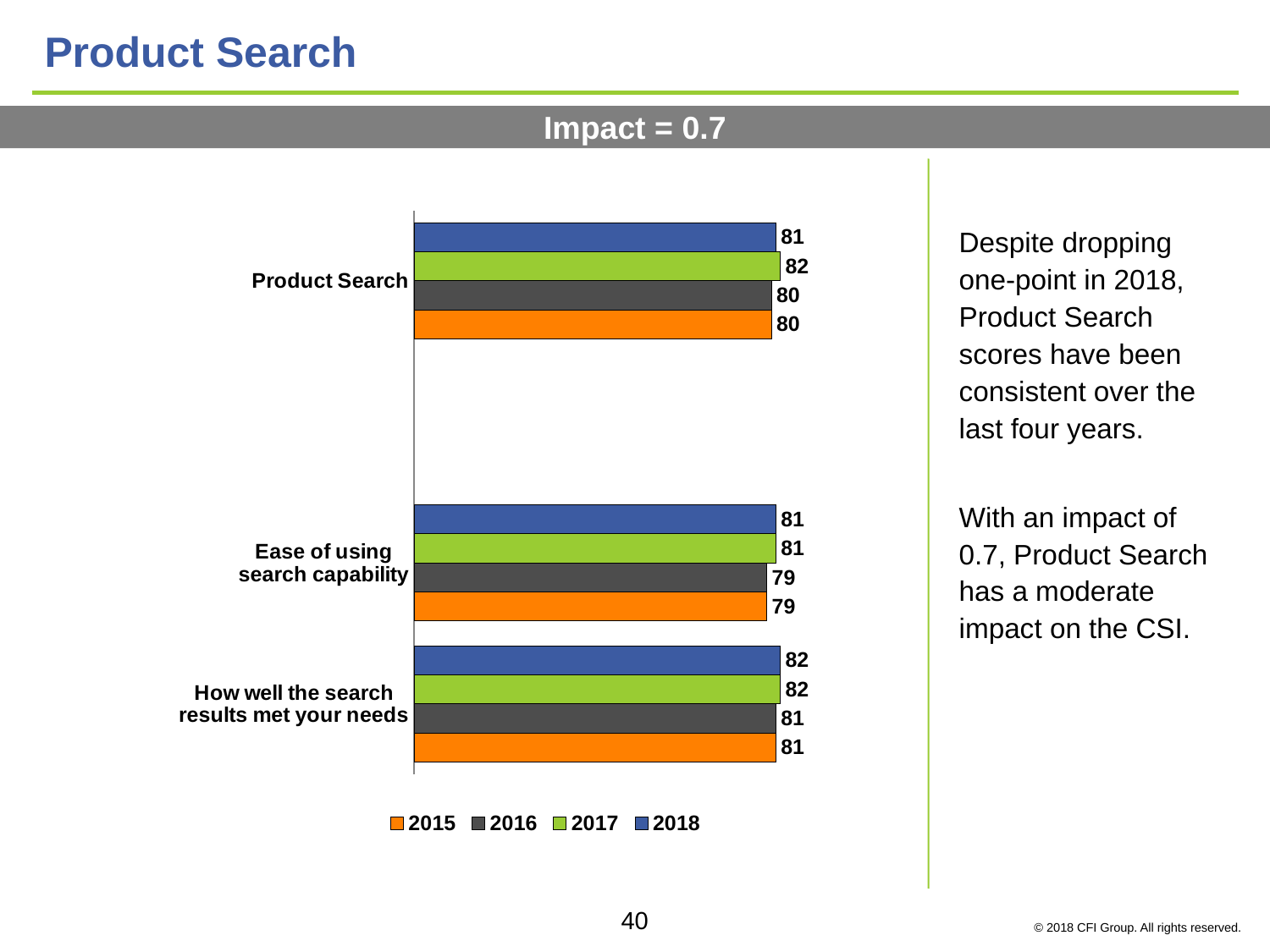
What is the 2015 value for Ease of using search capability? 79 What is the 2017 value for Product Search? 82 What is the difference between the 2018 and 2015 values for Ease of using search capability? 2 What kind of chart is shown on the slide? bar chart What impact value is shown in the banner above the chart? 0.7 What is the difference between the 2017 and 2016 values for Product Search? 2 How many series does the legend list? 4 What is the 2016 value for How well the search results met your needs? 81 What is the 2018 value for Product Search? 81 How many categories are shown on the chart? 3 Which year has the lowest value for Product Search, 2017 or 2016? 2016 Which category has the highest 2018 value? How well the search results met your needs